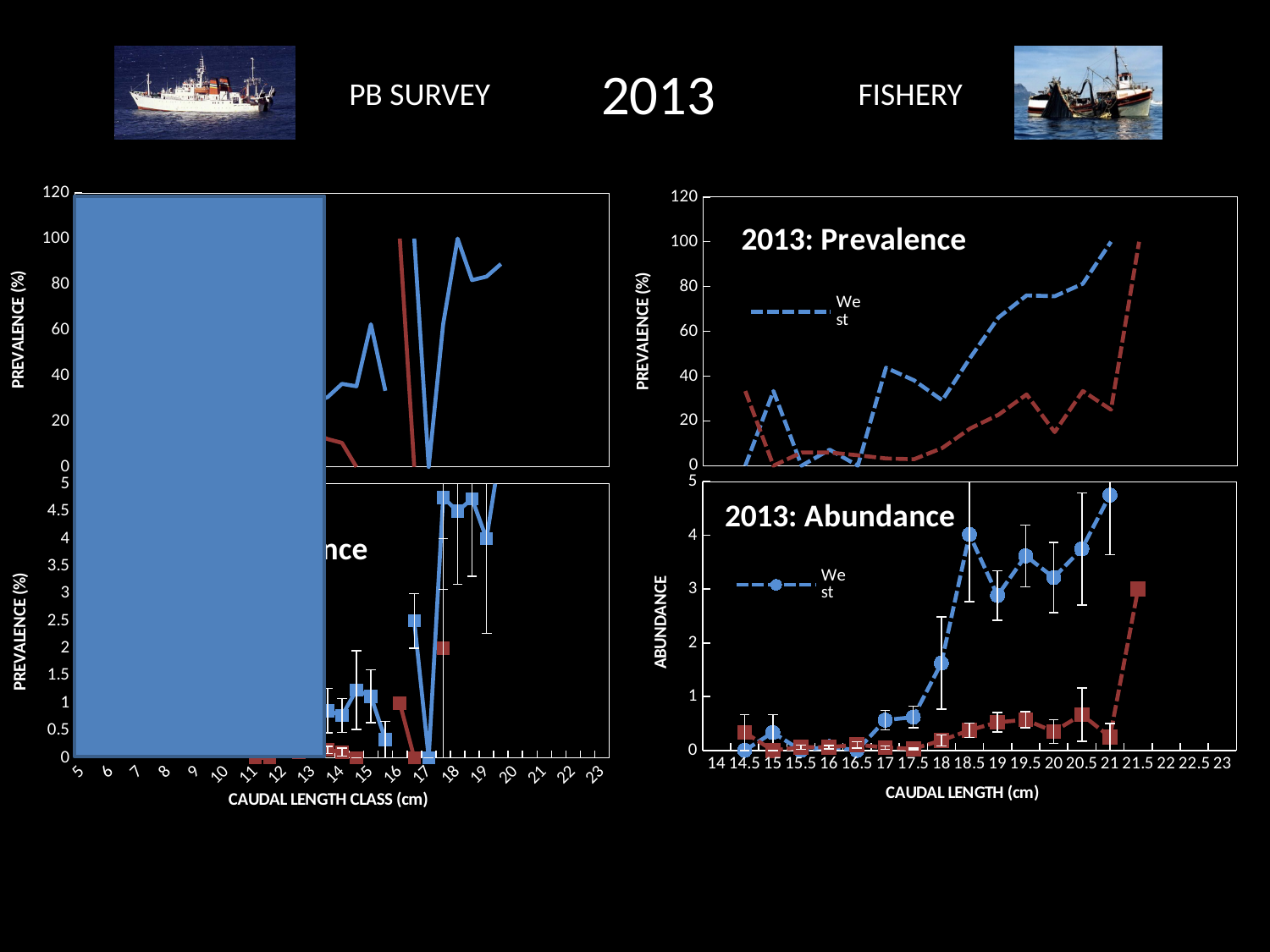
In the '2013: Prevalence' chart, is the blue (West) value at caudal length 21 greater or less than 80? greater What kind of chart is the '2013: Prevalence' chart on the right of the slide? line chart In the '2013: Abundance' chart, is the blue (West) value at caudal length 21 greater or less than 4? greater In the '2013: Prevalence' chart, does the blue (West) line rise or fall between caudal length 18 and 21? rise What kind of chart is the '2013: Abundance' chart on the right of the slide? line chart In the '2013: Abundance' chart, is the red value at caudal length 21.5 greater or less than 2? greater What is the x-axis title of the bottom-left chart? CAUDAL LENGTH CLASS (cm) In the '2013: Abundance' chart, at caudal length 18.5, which series has the larger value, the blue (West) series or the red series? blue (West) In the '2013: Abundance' chart, at which caudal length does the blue (West) series reach its highest value? 21 What is the x-axis title of the '2013: Abundance' chart? CAUDAL LENGTH (cm)